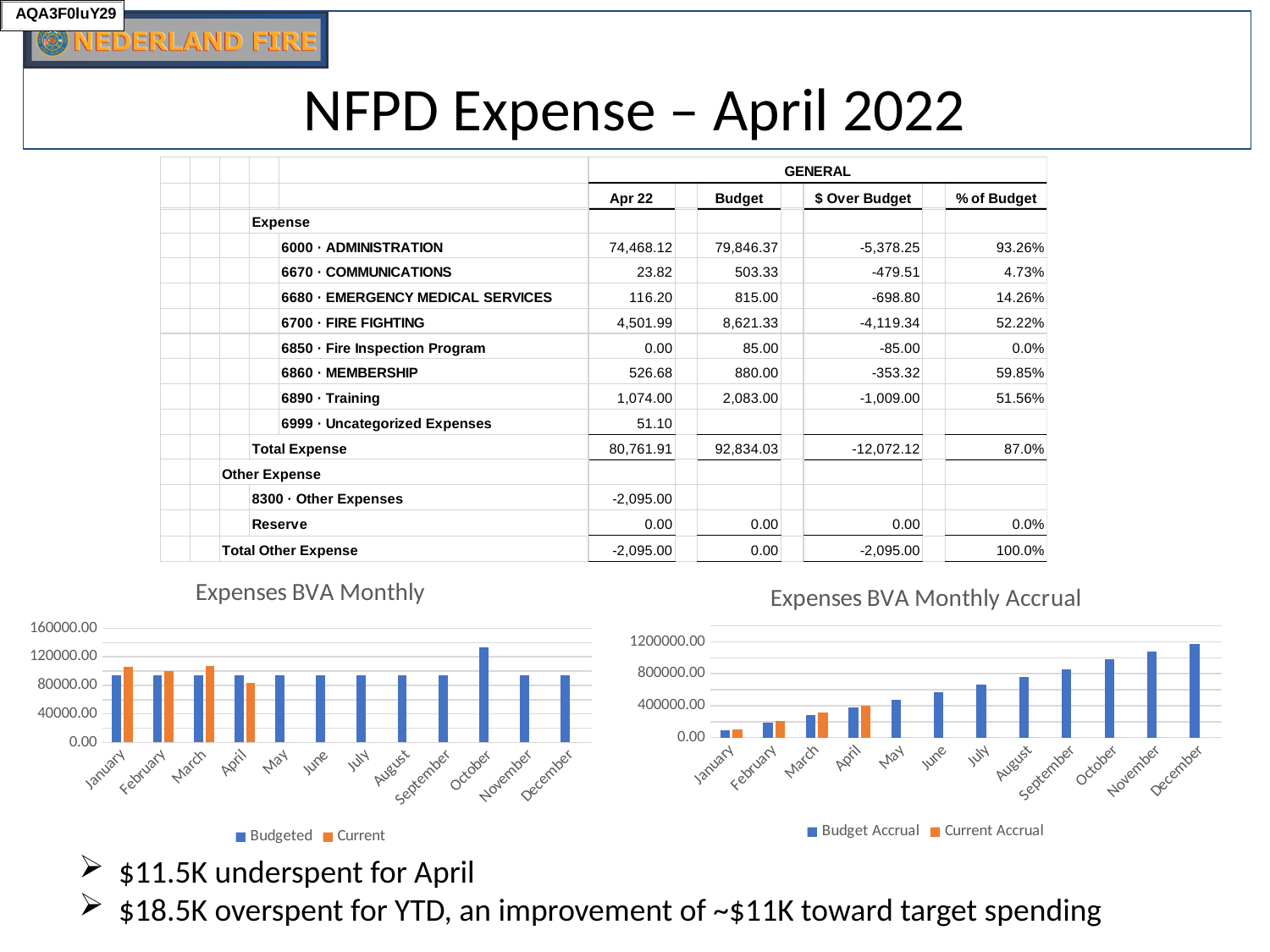
How many series does the legend of the "Expenses BVA Monthly Accrual" chart list? 2 What are the two legend entries of the "Expenses BVA Monthly" chart? Budgeted and Current In the "Expenses BVA Monthly" chart, which is larger for April: the Budgeted value or the Current value? Budgeted In the "Expenses BVA Monthly" chart, which month has the highest Budgeted value? October In the "Expenses BVA Monthly Accrual" chart, is the Budget Accrual value for January greater or less than 400000.00? less What kind of chart is the "Expenses BVA Monthly" chart? bar chart In the "Expenses BVA Monthly Accrual" chart, which month has the highest Budget Accrual value? December How many months are shown on the x axis of the "Expenses BVA Monthly" chart? 12 In the "Expenses BVA Monthly" chart, which is larger for March: the Budgeted value or the Current value? Current In the "Expenses BVA Monthly Accrual" chart, do the Budget Accrual values rise or fall from January to December? rise In the "Expenses BVA Monthly" chart, is the Budgeted value for October greater or less than 120000.00? greater In the "Expenses BVA Monthly Accrual" chart, is the Budget Accrual value for December greater or less than 800000.00? greater